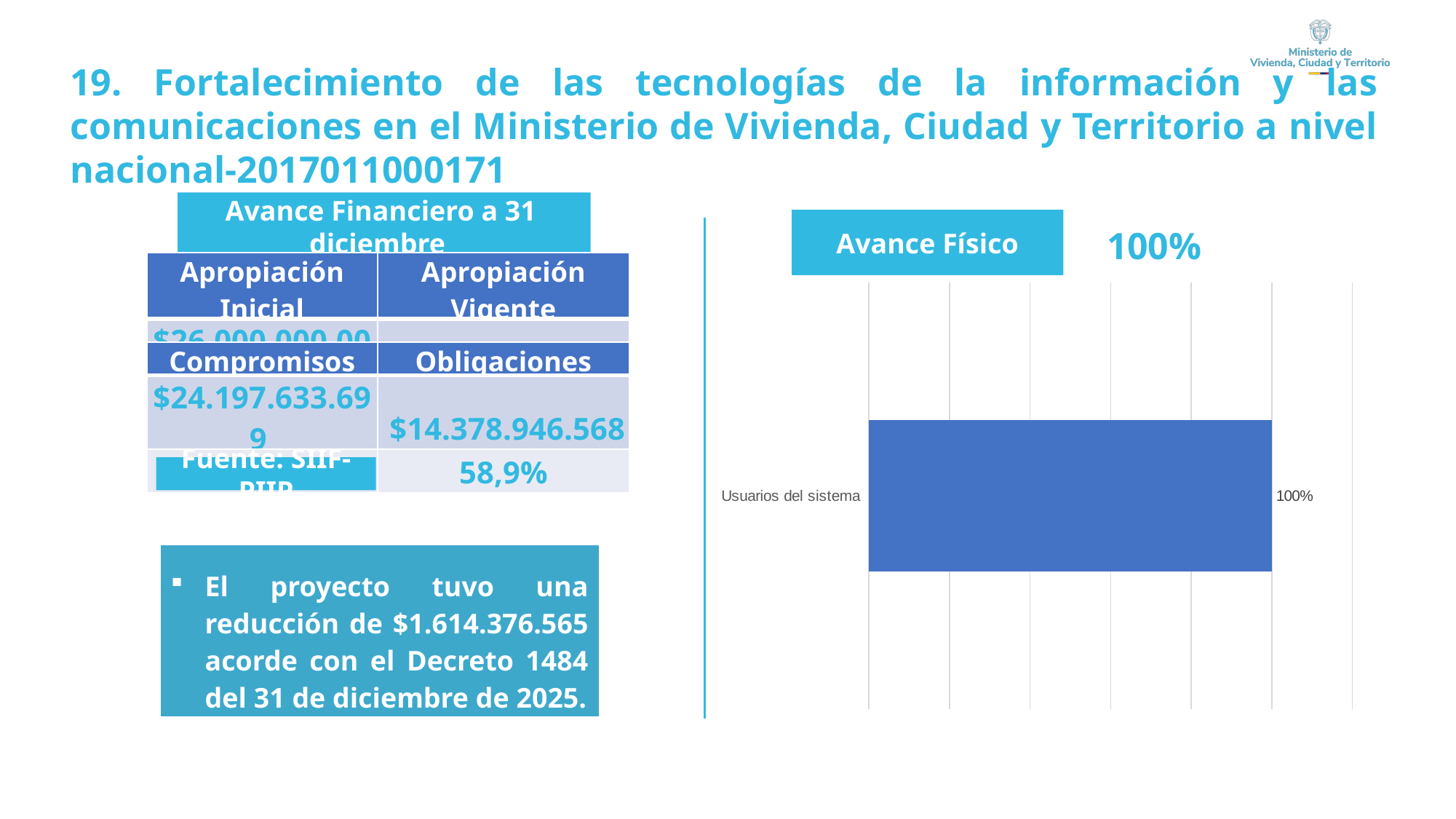
What is the title of the chart on the right side of the slide? Avance Físico What kind of chart is the Avance Físico chart? Bar chart Are the bars in the Avance Físico chart horizontal or vertical? Horizontal What is the value shown for Usuarios del sistema in the Avance Físico chart? 100% How many categories are plotted in the Avance Físico chart? 1 What is the label of the category plotted in the Avance Físico chart? Usuarios del sistema